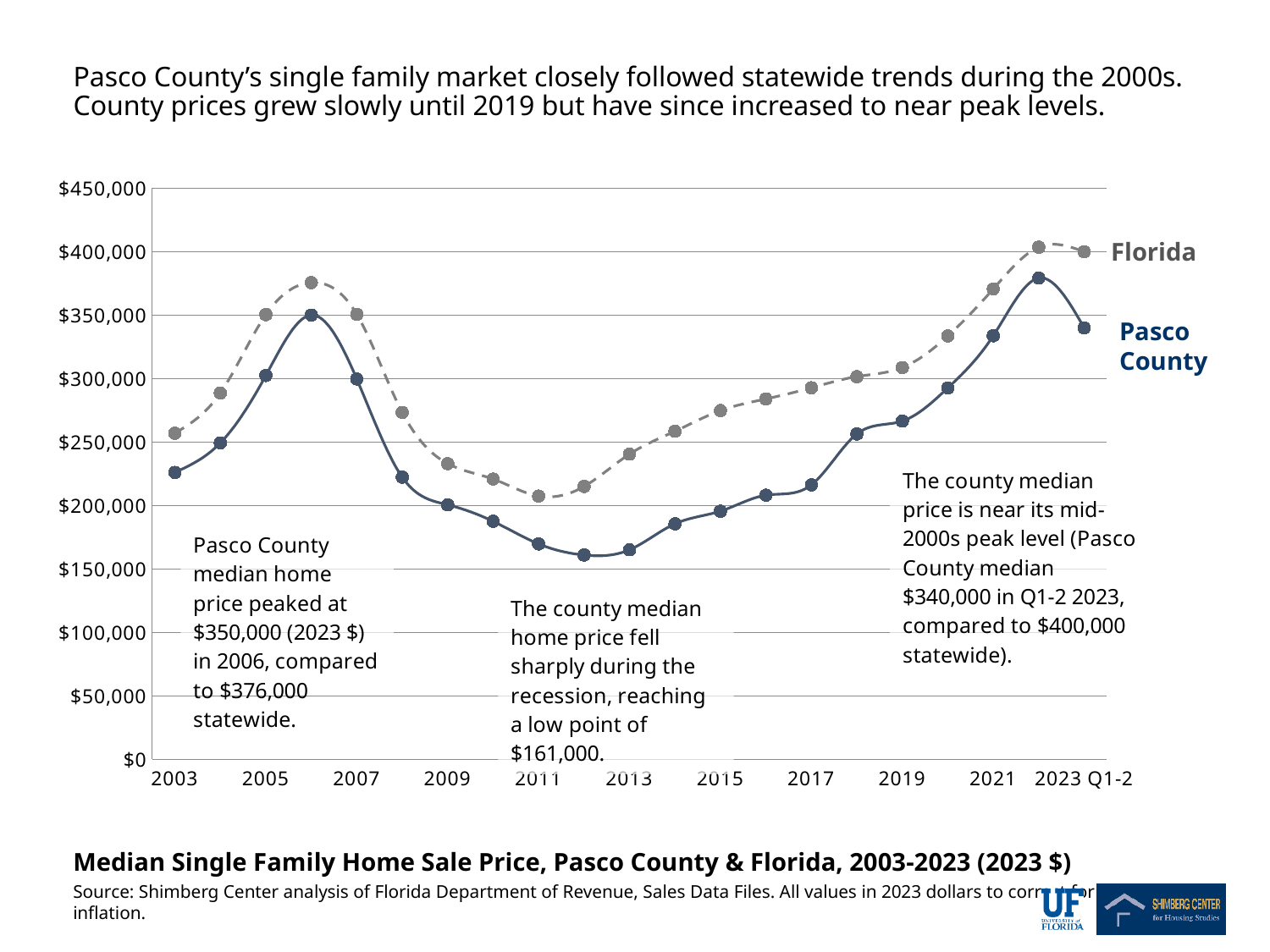
How many series are plotted on the chart? 2 What was the Pasco County median home price at its 2006 peak? $350,000 In 2006, which was higher: the Florida median or the Pasco County median? Florida What was the low point of the Pasco County median home price during the recession? $161,000 What was the difference between the Florida and Pasco County median home prices in 2006? $26,000 What kind of chart is shown on the slide? line chart Did the Pasco County median home price rise or fall between 2012 and 2022? rise What was the statewide (Florida) median home price in 2006? $376,000 What was the difference between the Florida and Pasco County median home prices in Q1-2 2023? $60,000 Is the Florida value for 2017 greater or less than $300,000? less What was the Pasco County median home price in Q1-2 2023? $340,000 Is the Pasco County value for 2017 greater or less than $200,000? greater